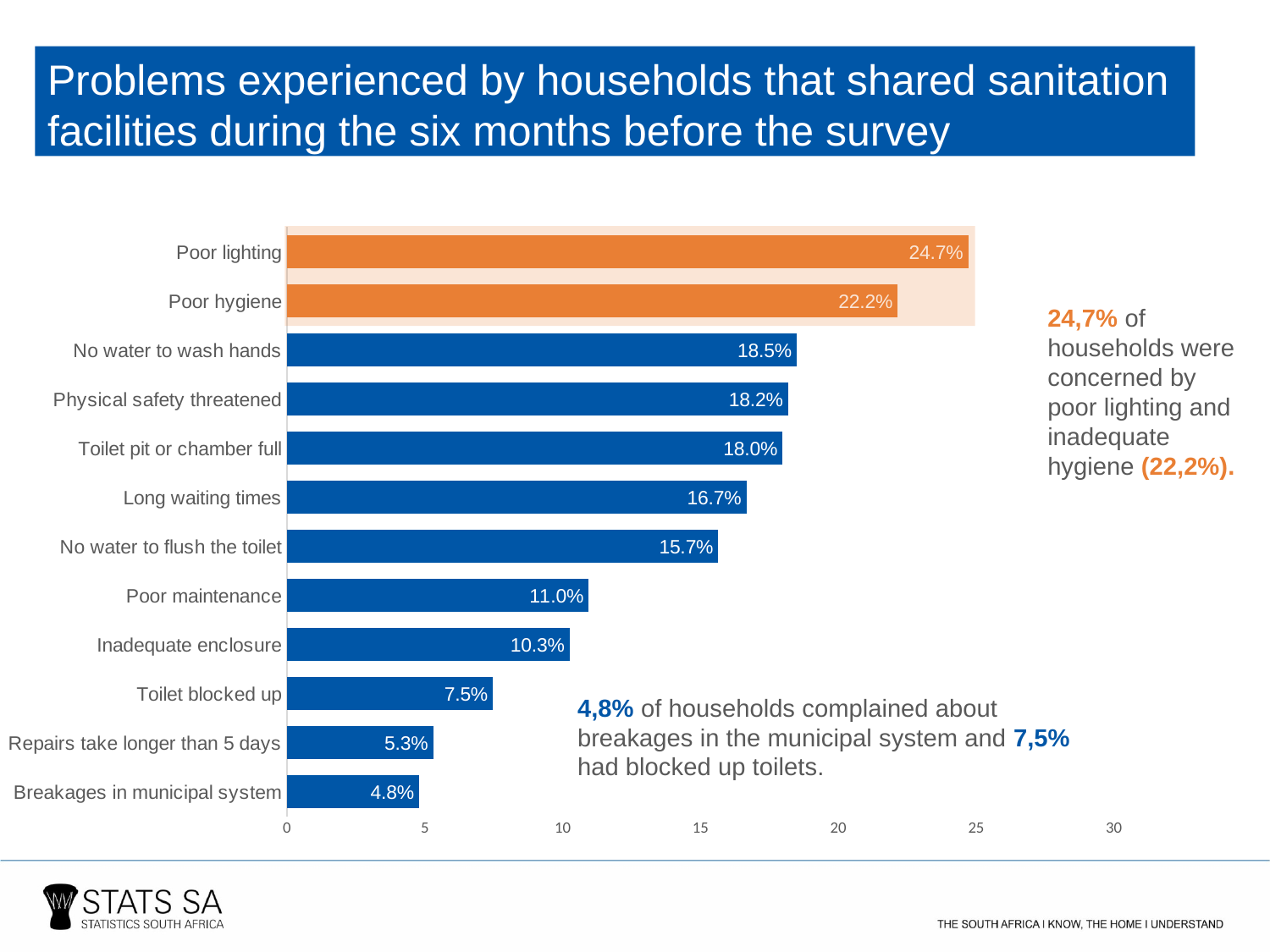
How many problem categories are shown in the chart? 12 Which problem has the highest percentage of households? Poor lighting Which is larger, the value for 'Long waiting times' or the value for 'Toilet pit or chamber full'? Toilet pit or chamber full What is the difference between the values for 'Poor maintenance' and 'Inadequate enclosure'? 0.7% What is the difference between the values for 'Poor lighting' and 'Poor hygiene'? 2.5% What kind of chart is shown on the slide? Bar chart Is the value for 'Toilet blocked up' greater or less than 10? less Which problem has the lowest percentage of households? Breakages in municipal system What is the value shown for 'Repairs take longer than 5 days'? 5.3% What percentage of households reported poor lighting as a problem? 24.7% What is the value shown for 'No water to flush the toilet'? 15.7% Which two bars are coloured orange rather than blue? Poor lighting and Poor hygiene